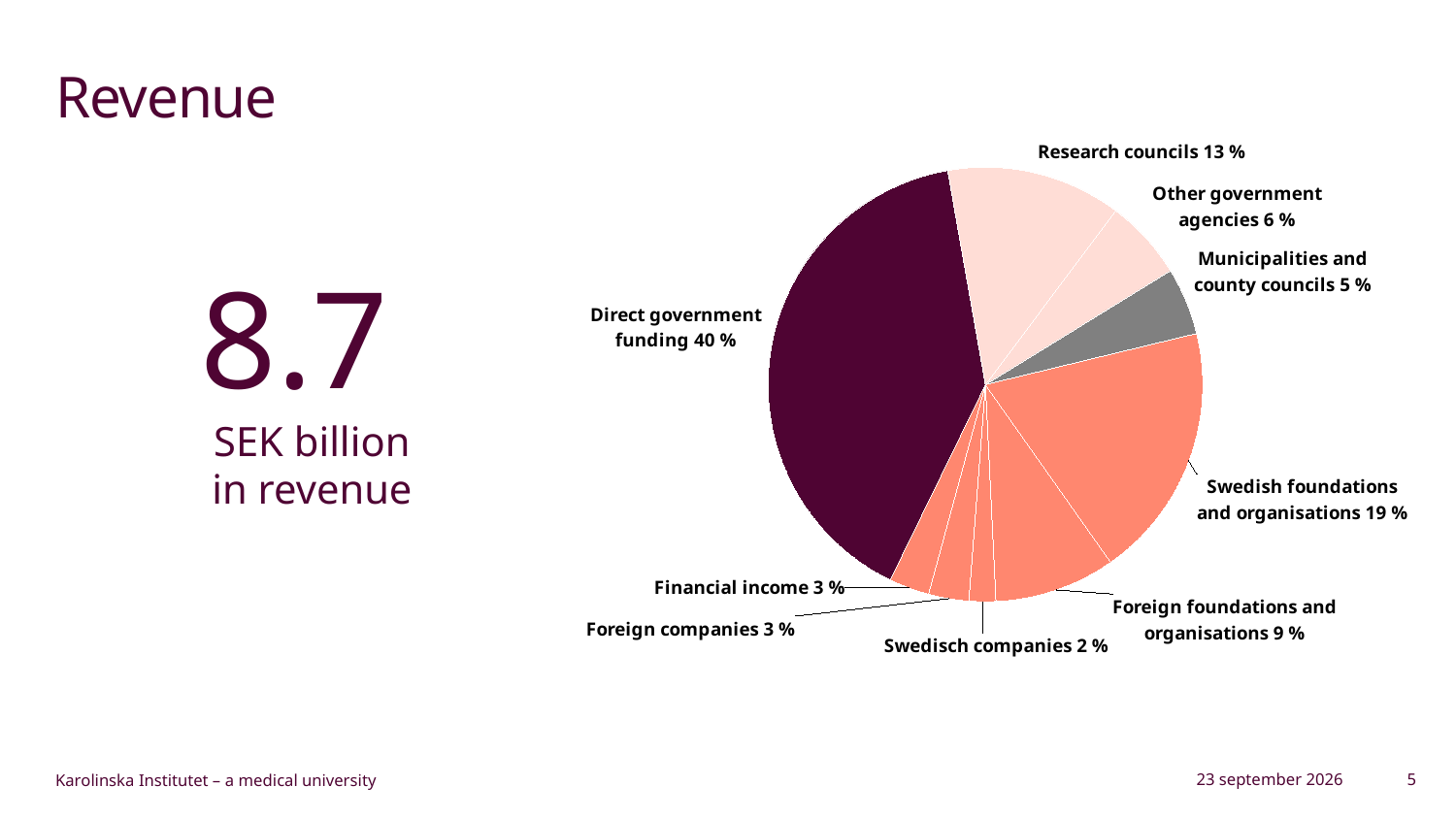
What share of revenue comes from Foreign foundations and organisations? 9 % Which revenue source has the smallest share of the pie? Swedisch companies What kind of chart is shown on the slide? Pie chart What share of revenue comes from Direct government funding? 40 % What share of revenue comes from Swedish foundations and organisations? 19 % What share of revenue comes from Research councils? 13 % Which revenue source has the largest share of the pie? Direct government funding How many slices does the pie chart have? 9 What total revenue figure is shown on the slide next to the pie chart? 8.7 SEK billion What share of revenue comes from Municipalities and county councils? 5 % What is the difference in percentage points between Direct government funding and Swedish foundations and organisations? 21 Which is larger, the share for Research councils or the share for Other government agencies? Research councils